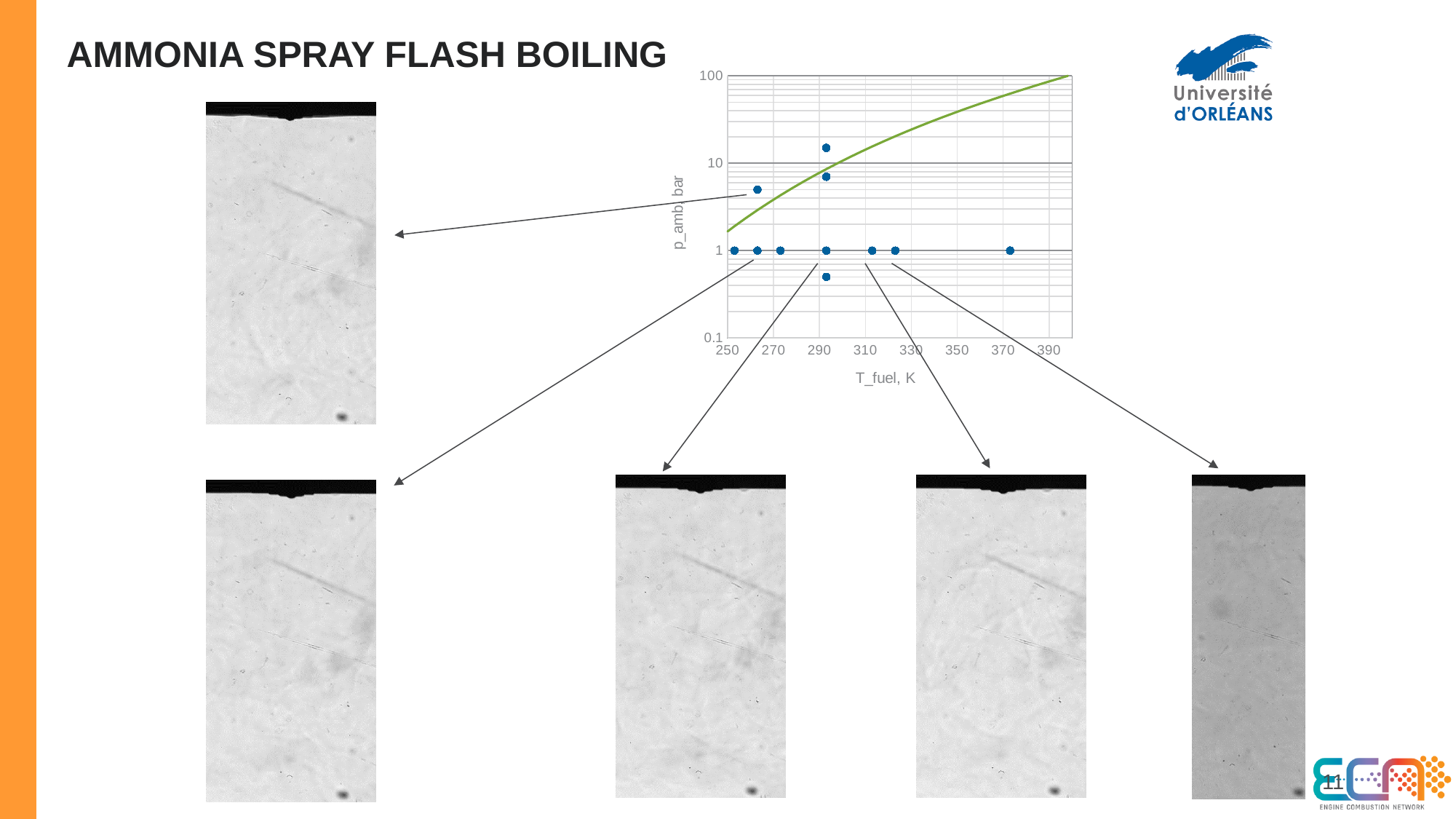
What is the last tick value shown on the x axis of the chart? 390 Is the p_amb value of the highest blue data point greater or less than 10? greater Is the T_fuel value of the rightmost blue data point greater or less than 350? greater What is the first tick value shown on the x axis of the chart? 250 What is the label of the y axis of the chart? p_amb, bar What is the highest tick value shown on the y axis of the chart? 100 What is the lowest tick value shown on the y axis of the chart? 0.1 Is the p_amb value of the lowest blue data point greater or less than 1? less What is the label of the x axis of the chart? T_fuel, K What kind of chart is shown on the slide? scatter chart Does the green curve rise or fall as T_fuel increases? rises